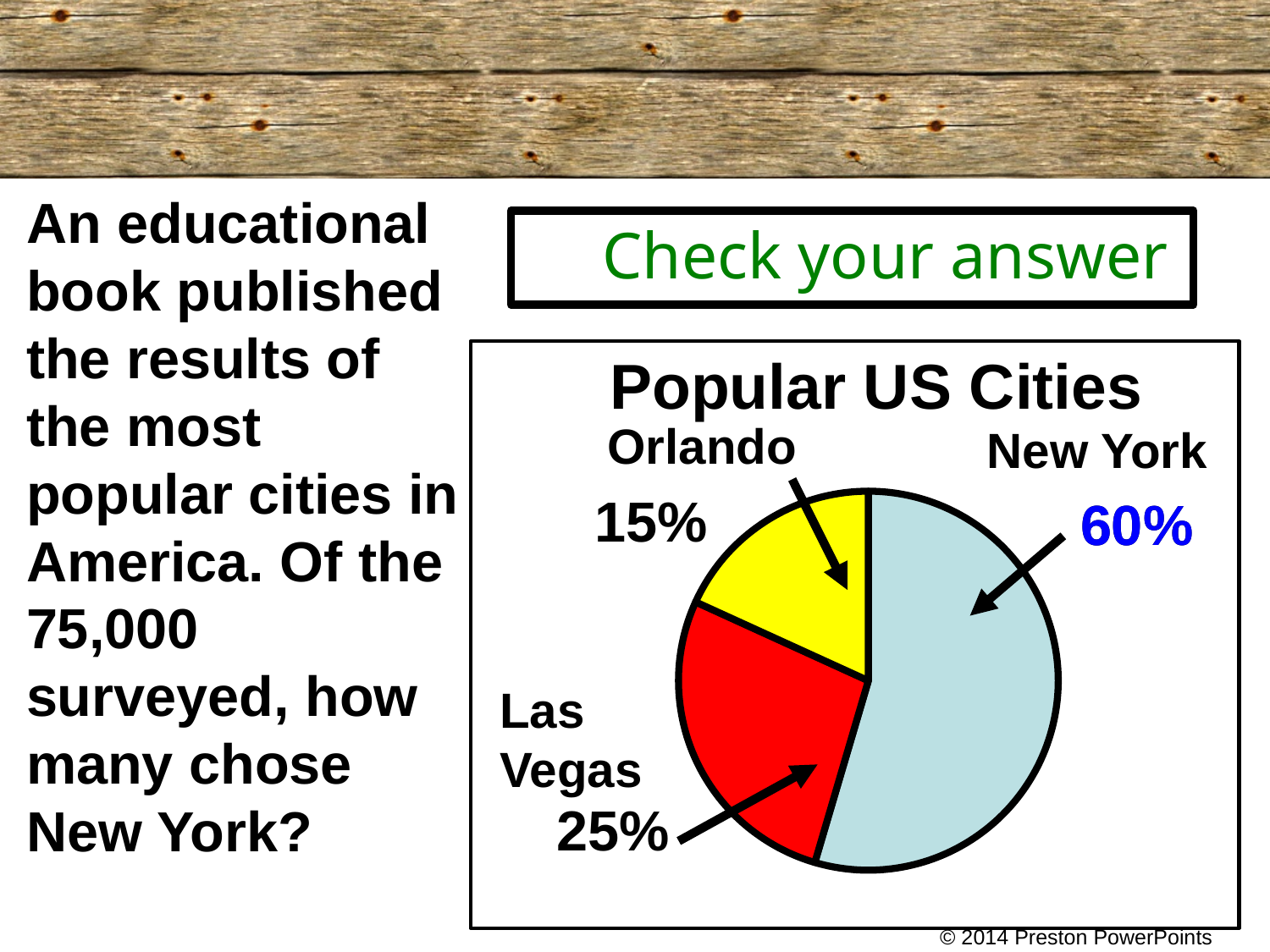
Which city has the largest share of the pie? New York What percentage of the pie is New York? 60% What percentage of the pie is Orlando? 15% What is the difference in percentage points between Las Vegas and Orlando? 10% What colour is the New York slice? light blue What type of chart is shown on the slide? pie chart How many slices does the pie chart have? 3 Which has a larger share, Las Vegas or Orlando? Las Vegas What is the title of the chart? Popular US Cities Which city has the smallest share of the pie? Orlando What is the difference in percentage points between New York and Las Vegas? 35% What percentage of the pie is Las Vegas? 25%